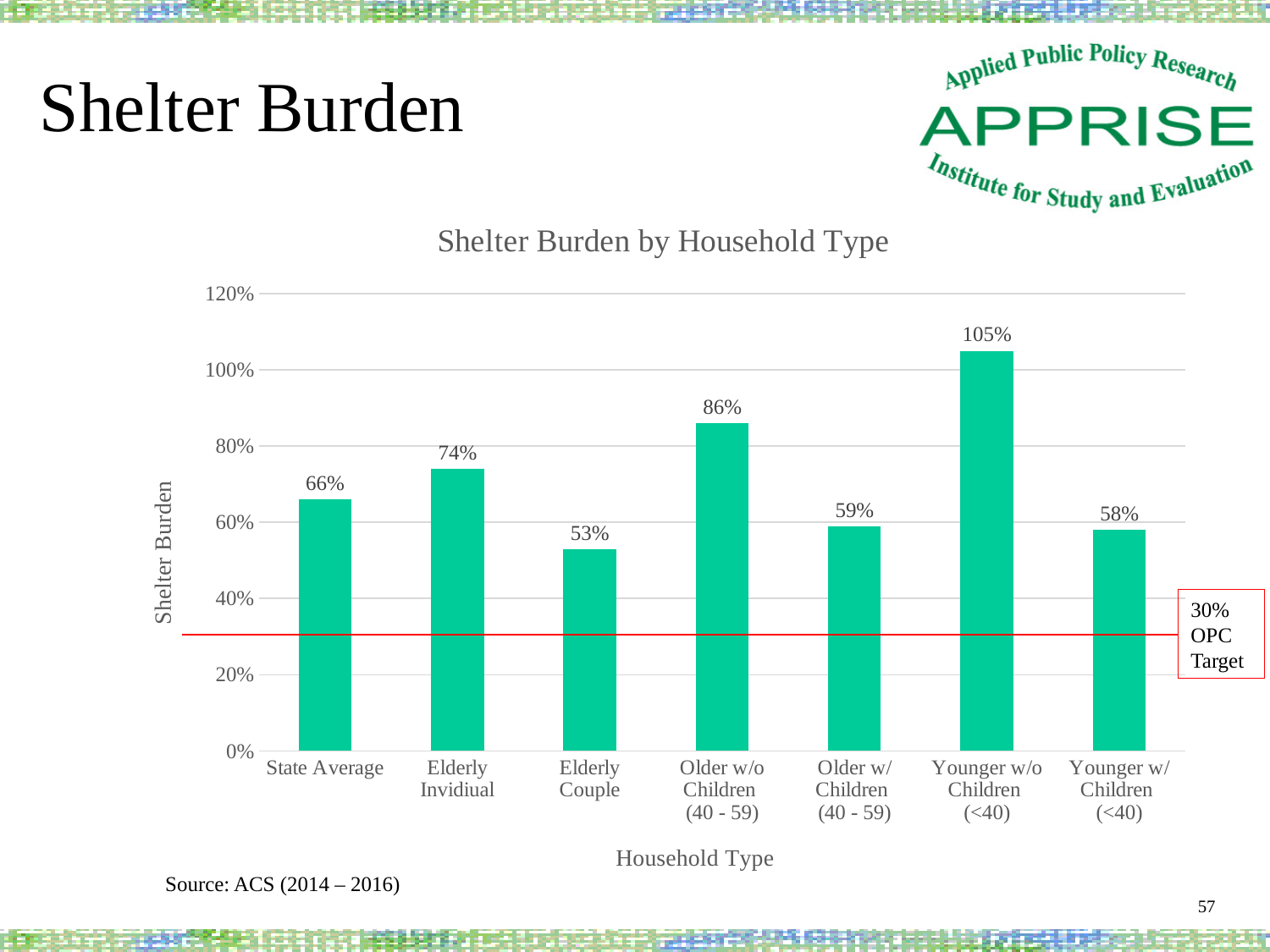
What is the difference in shelter burden between Younger w/o Children (<40) and Younger w/ Children (<40)? 47% Is the shelter burden for Elderly Invidiual greater or less than 60%? greater Which has a higher shelter burden, Elderly Invidiual or Older w/ Children (40 - 59)? Elderly Invidiual What is the shelter burden for Older w/o Children (40 - 59) households? 86% Which household type has the lowest shelter burden? Elderly Couple What kind of chart is shown on the slide? Bar chart What is the shelter burden for Elderly Couple households? 53% What is the title of the chart? Shelter Burden by Household Type What is the shelter burden for the State Average? 66% Which household type has the highest shelter burden? Younger w/o Children (<40) What value does the red horizontal line labelled OPC Target represent? 30% How many household types are shown in the chart? 7